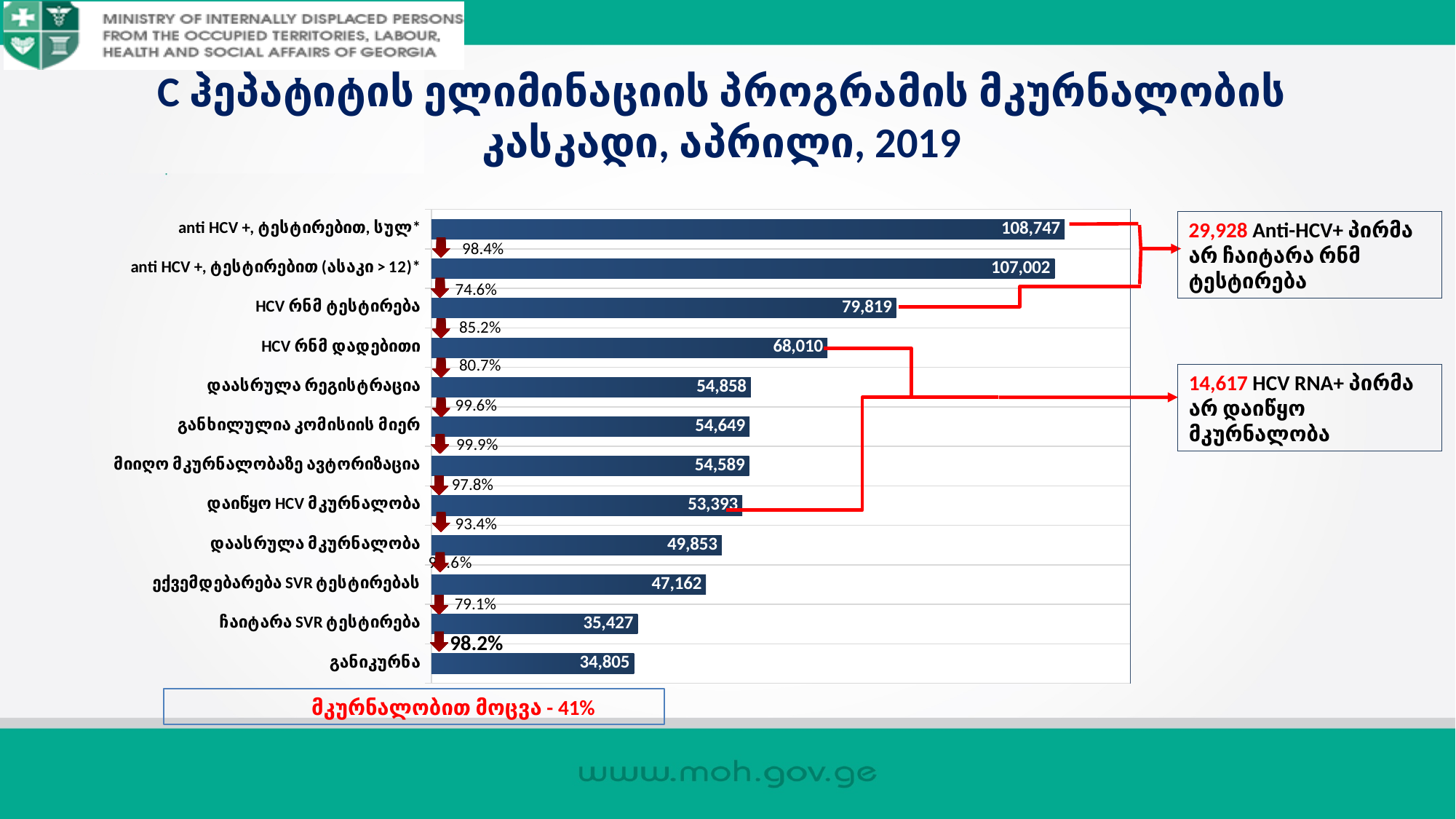
What is the difference between "HCV რნმ ტესტირება" and "HCV რნმ დადებითი"? 11,809 Which category has the lowest value? განიკურნა What is the value for "განიკურნა"? 34,805 What is the value for "anti HCV +, ტესტირებით, სულ*"? 108,747 Which is larger: "დაასრულა მკურნალობა" or "ექვემდებარება SVR ტესტირებას"? დაასრულა მკურნალობა What is the value for "HCV რნმ ტესტირება"? 79,819 What kind of chart is shown on the slide? bar chart Which category has the highest value? anti HCV +, ტესტირებით, სულ* How many categories (bars) does the chart show? 12 Do the bar values rise or fall going from the top of the chart to the bottom? fall What percentage is shown between "HCV რნმ ტესტირება" and "HCV რნმ დადებითი"? 85.2% What is the value for "დაიწყო HCV მკურნალობა"? 53,393